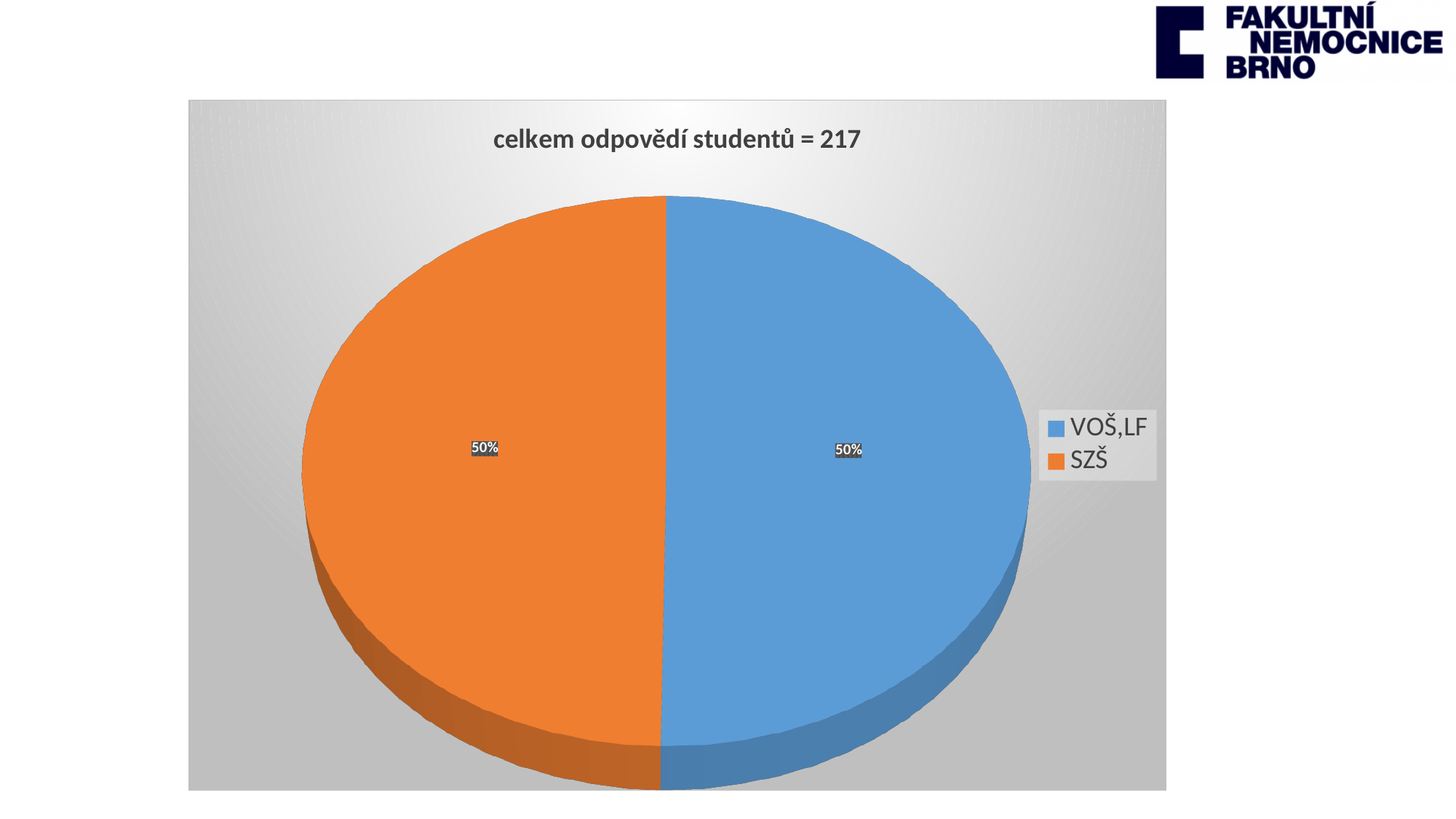
What is the total number of student responses stated in the chart title? 217 What share of the pie does the SZŠ slice represent? 50% How many slices does the pie chart have? 2 What is the title of the chart? celkem odpovědí studentů = 217 Which colour represents SZŠ in the pie chart? orange What is the difference between the shares of VOŠ,LF and SZŠ? 0% How many entries does the legend list? 2 What share of the pie does the VOŠ,LF slice represent? 50% What kind of chart is shown on the slide? pie chart